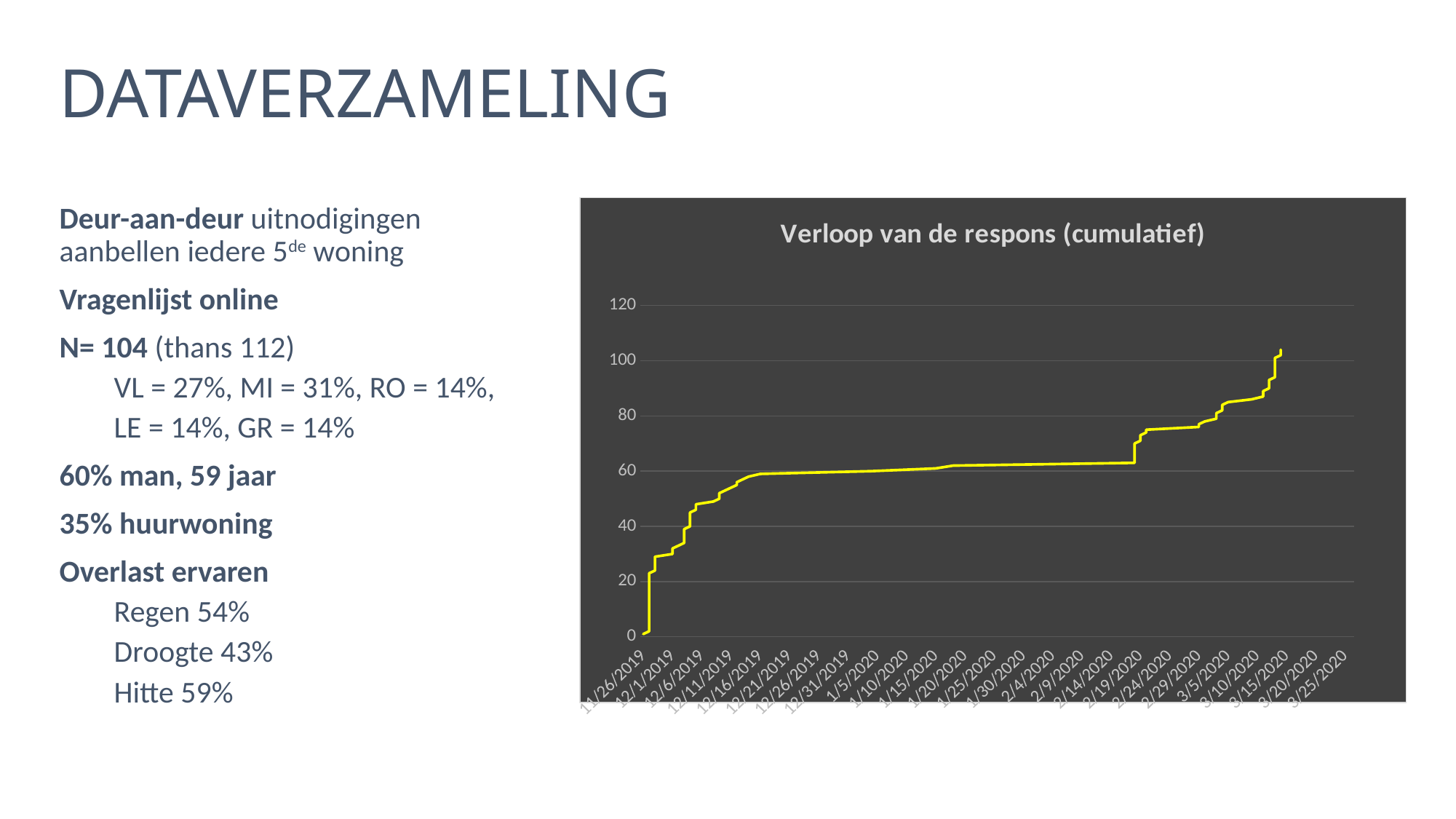
Is the value of the line on 12/1/2019 greater or less than 40? less Is the value of the line on 2/24/2020 greater or less than 60? greater Is the highest value reached by the line greater or less than 120? less What kind of chart is shown on the slide? line chart What colour is the line in the chart? yellow Does the line in the chart rise or fall from left to right along the x axis? rise What is the title of the chart? Verloop van de respons (cumulatief)